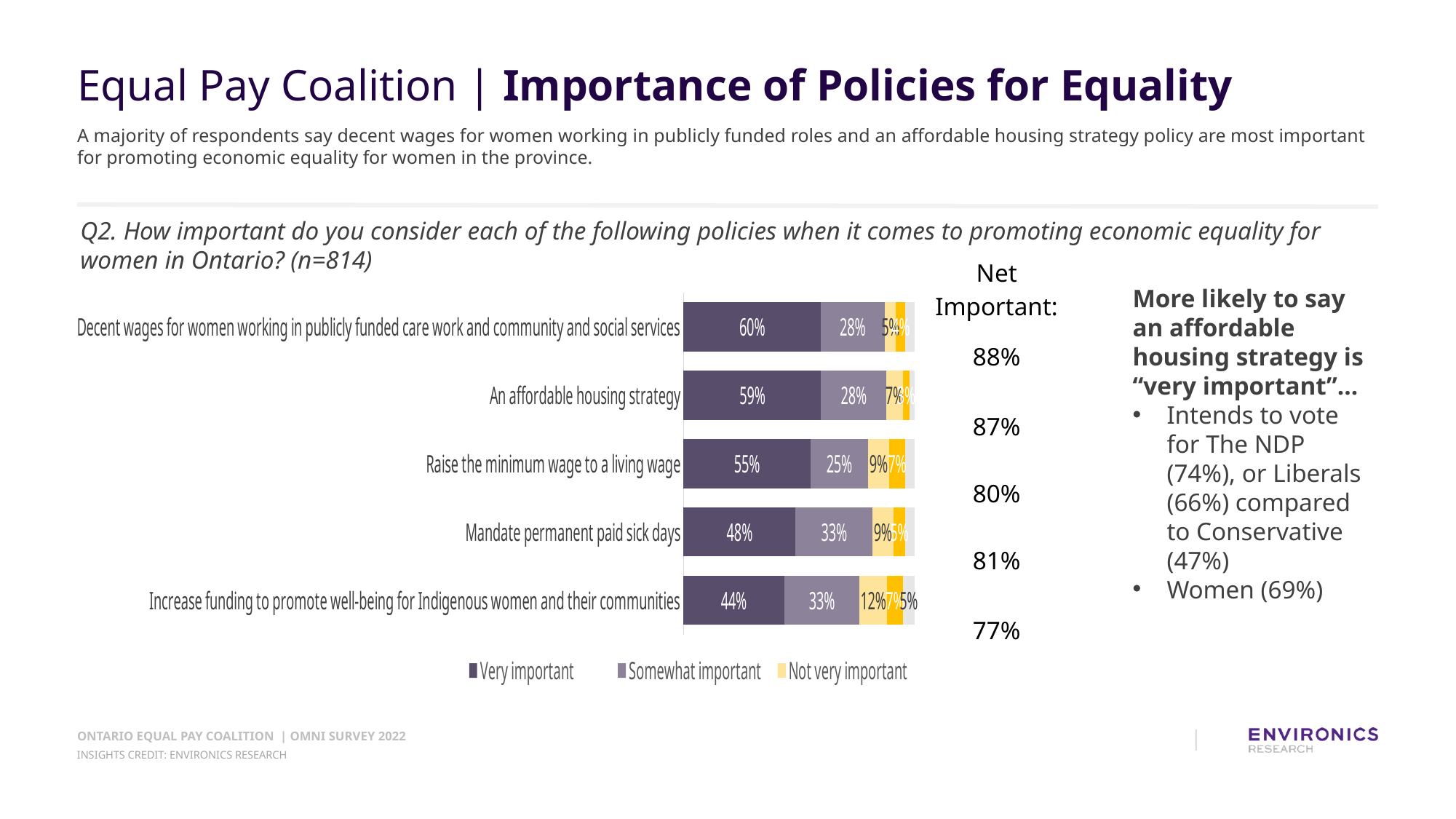
Which has a larger 'Not very important' share: 'An affordable housing strategy' or 'Raise the minimum wage to a living wage'? Raise the minimum wage to a living wage What is the 'Somewhat important' value for 'Mandate permanent paid sick days'? 33% What percentage of respondents say decent wages for women working in publicly funded care work and community and social services is very important? 60% What type of chart is used on this slide? Stacked bar chart How many series does the chart legend list? 3 Which policy has the lowest Net Important figure? Increase funding to promote well-being for Indigenous women and their communities Which policy has the highest 'Very important' percentage? Decent wages for women working in publicly funded care work and community and social services What is the difference between the 'Very important' values for 'An affordable housing strategy' and 'Mandate permanent paid sick days'? 11 percentage points Which policy has the lowest 'Very important' percentage? Increase funding to promote well-being for Indigenous women and their communities What is the 'Not very important' value for 'Increase funding to promote well-being for Indigenous women and their communities'? 12% What is the Net Important figure for 'Raise the minimum wage to a living wage'? 80% How many policies are shown in the chart? 5